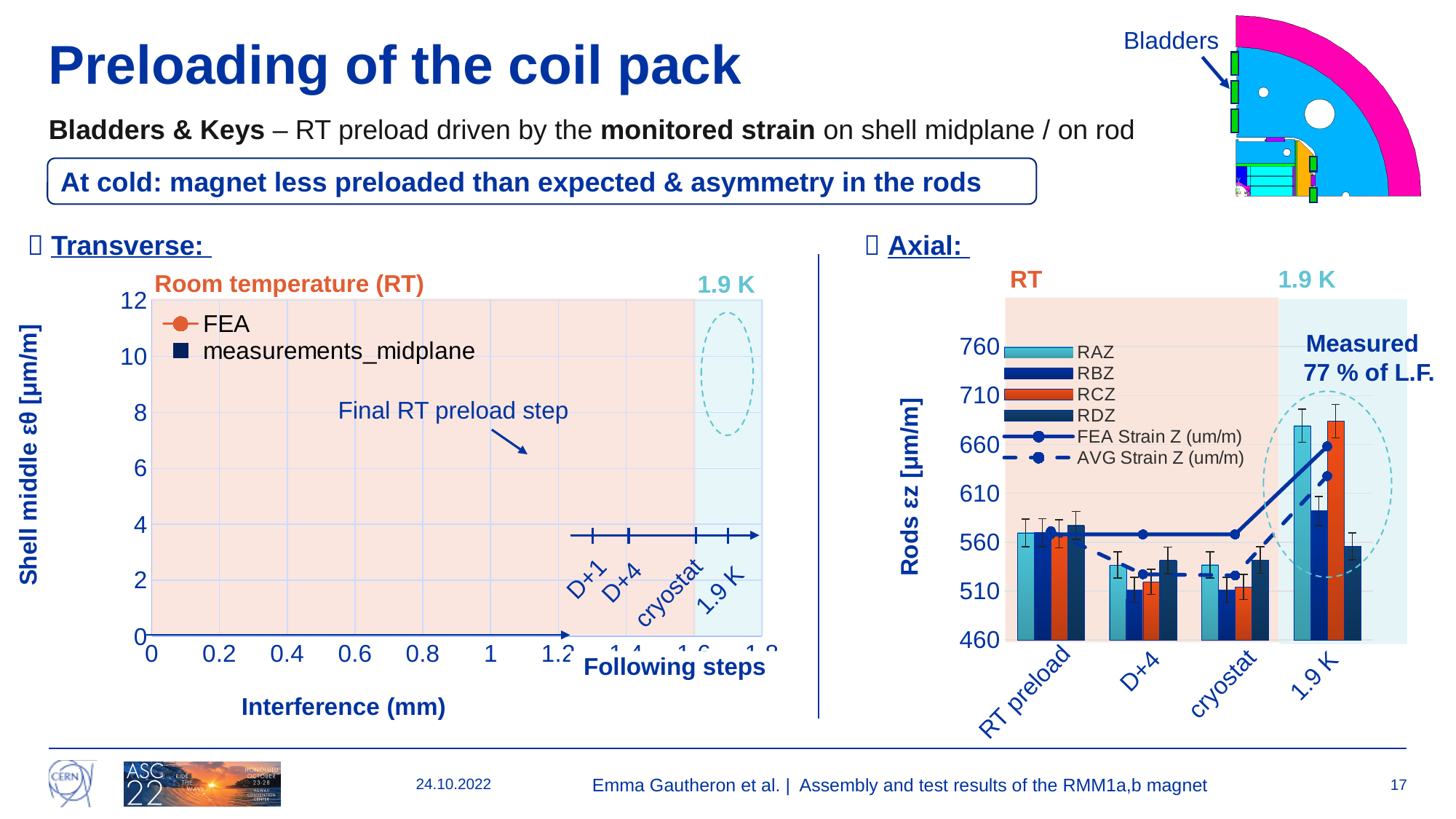
On the Axial chart, does the FEA Strain Z line rise or fall from cryostat to 1.9 K? rise On the Axial chart, how many entries does the legend list? 6 On the Axial chart, is the RAZ value at 1.9 K greater or less than 660? greater On the Transverse chart, how many series does the legend list? 2 On the Axial chart, is the RBZ value at 1.9 K greater or less than 610? less On the Axial chart, is the RDZ value larger at RT preload or at D+4? RT preload On the Axial chart, how many categories are shown on the x axis? 4 On the Axial chart, at which category is the RAZ bar highest? 1.9 K On the Axial chart, which series has the lowest bar at 1.9 K? RDZ On the Axial chart, what kind of chart is used for the RAZ, RBZ, RCZ and RDZ series? bar chart On the Axial chart, is the RCZ value at cryostat greater or less than 560? less